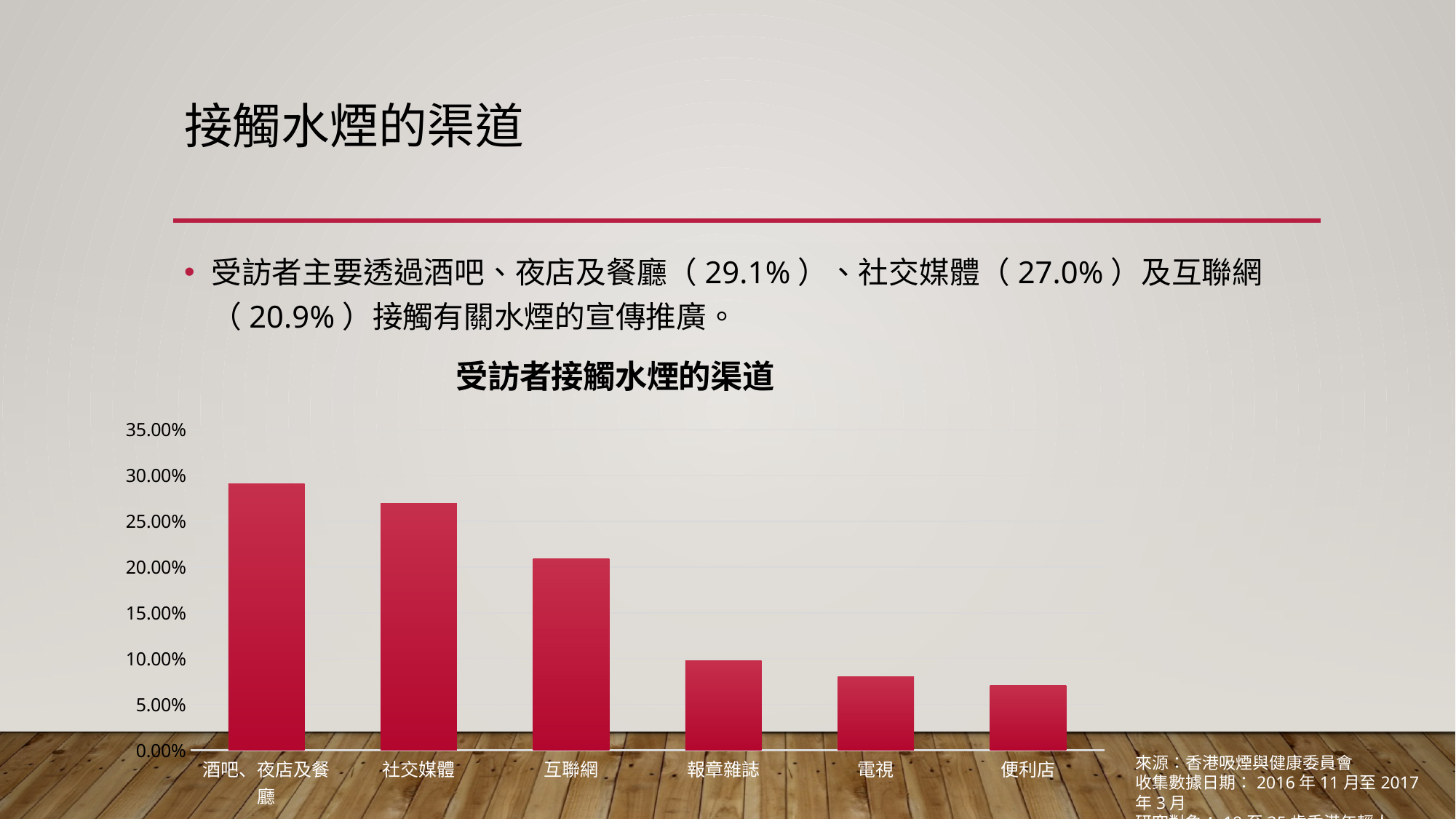
Which category has the highest value in the chart? 酒吧、夜店及餐廳 What is the value for 互聯網? 20.9% Which category has the lowest value in the chart? 便利店 What is the value for 社交媒體? 27.0% What is the title of the chart? 受訪者接觸水煙的渠道 What is the difference between the values for 酒吧、夜店及餐廳 and 社交媒體? 2.1% How many categories are shown on the x axis of the chart? 6 What kind of chart is shown on the slide? bar chart Do the values rise or fall from left to right along the x axis? fall Is the value for 報章雜誌 greater or less than 15.00%? less What is the value for 酒吧、夜店及餐廳? 29.1% Is the value for 電視 greater or less than 10.00%? less